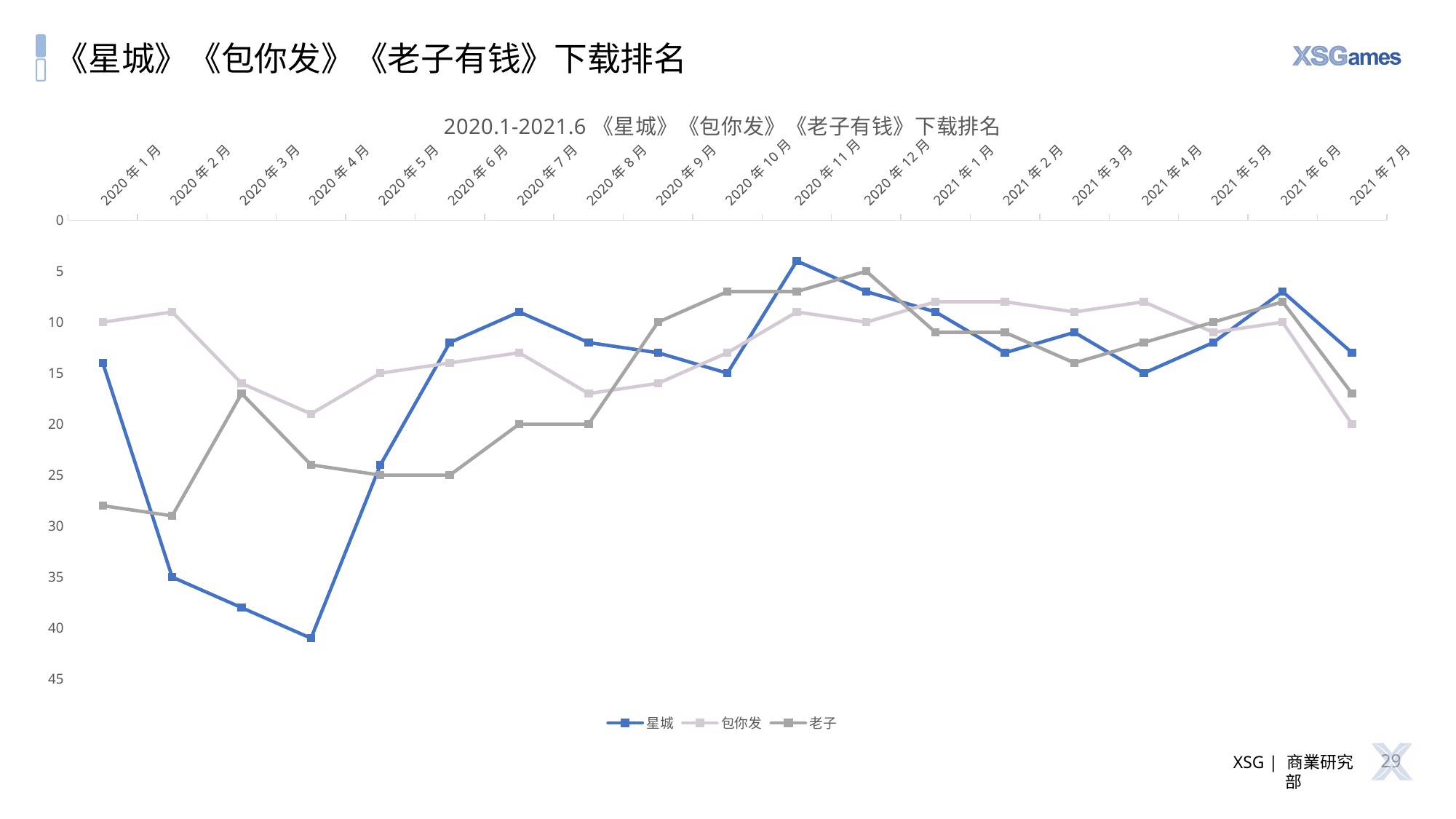
How many series does the legend list? 3 What is the value for 星城 in 2020年2月? 35 Which series is drawn in blue? 星城 What is the title of the chart? 2020.1-2021.6 《星城》《包你发》《老子有钱》下载排名 Is the value for 老子 in 2020年1月 greater or less than 25? greater In which month does 星城 reach its highest value? 2020年4月 Is the value for 包你发 in 2020年3月 greater or less than 20? less What is the value for 包你发 in 2021年6月? 10 Is the value for 星城 in 2020年4月 greater or less than 40? greater What kind of chart is shown on the slide? line chart In 2020年1月, which series has the larger value, 星城 or 老子? 老子